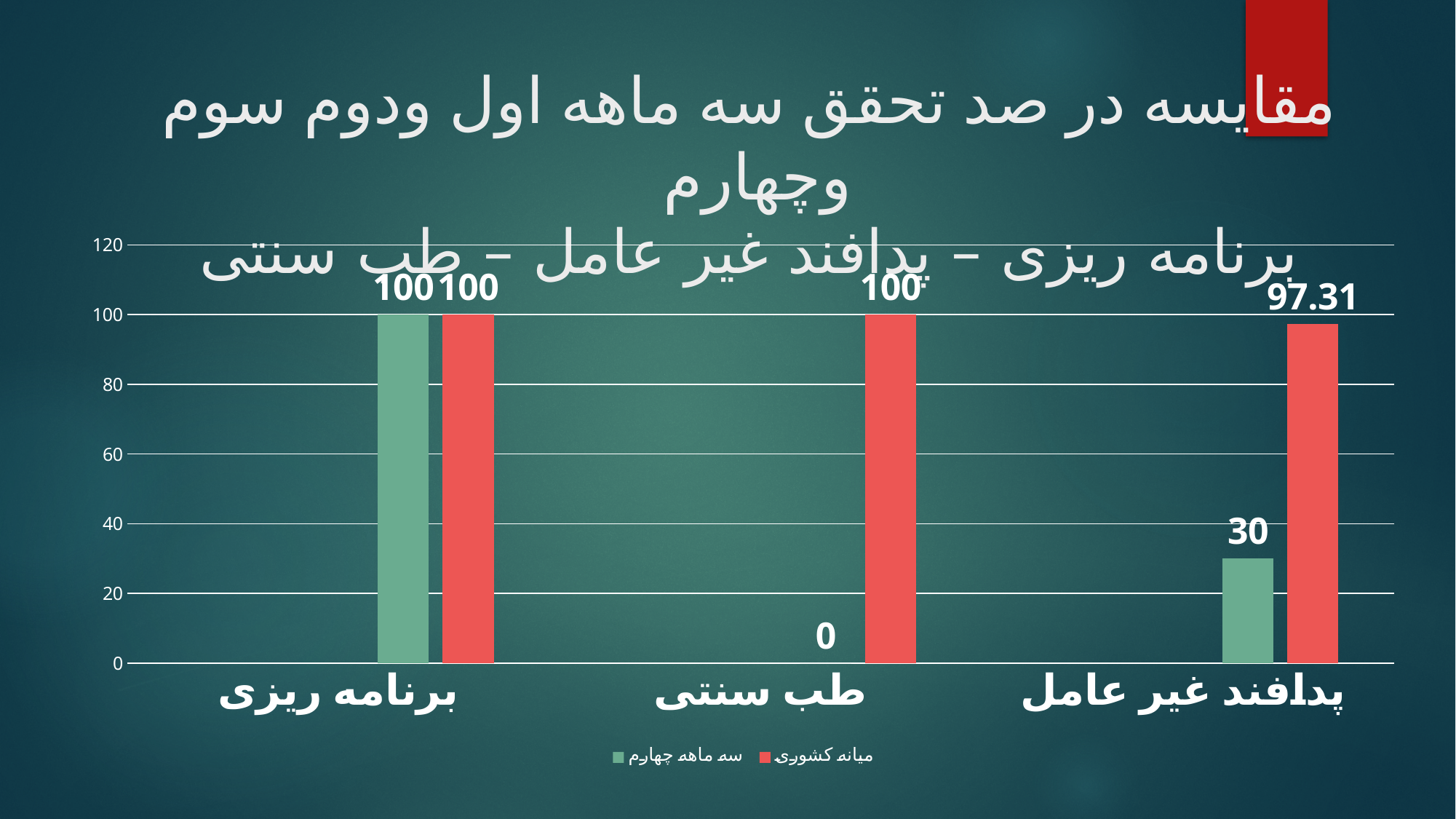
Which category has the lowest value for سه ماهه چهارم? طب سنتی What is the value of میانه کشوری for پدافند غیر عامل? 97.31 What type of chart is shown on the slide? bar chart What is the difference between میانه کشوری and سه ماهه چهارم for پدافند غیر عامل? 67.31 How many series does the legend list? 2 How many categories are shown on the x axis of the chart? 3 What is the value of میانه کشوری for برنامه ریزی? 100 What is the value of سه ماهه چهارم for طب سنتی? 0 Which series is shown in red in the legend? میانه کشوری Which category has the lowest value for میانه کشوری? پدافند غیر عامل What is the value of سه ماهه چهارم for پدافند غیر عامل? 30 For پدافند غیر عامل, which is larger: سه ماهه چهارم or میانه کشوری? میانه کشوری